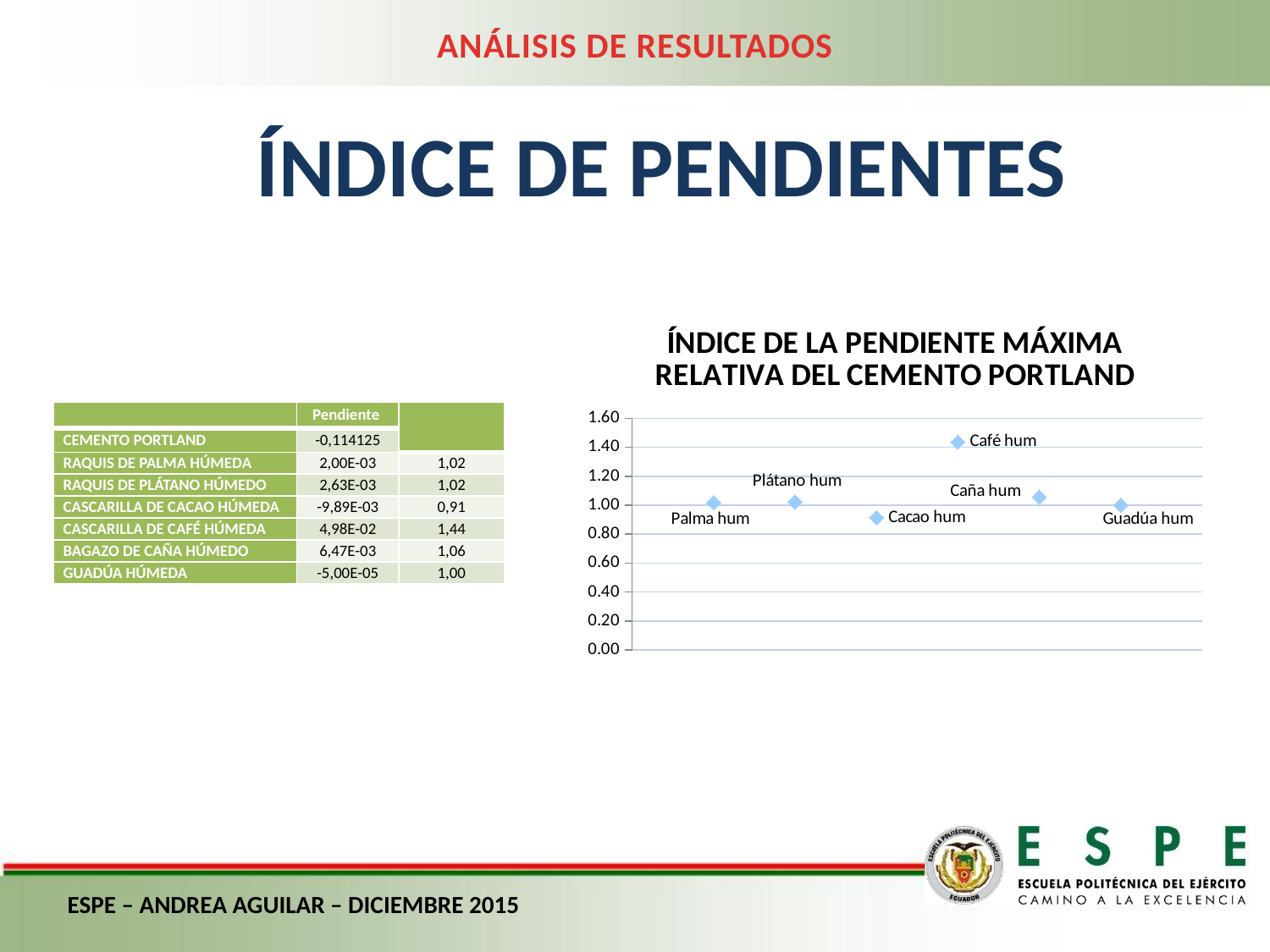
What is the title of the chart on the slide? ÍNDICE DE LA PENDIENTE MÁXIMA RELATIVA DEL CEMENTO PORTLAND Which has the larger value, Palma hum or Cacao hum? Palma hum What is the highest value shown on the vertical axis of the chart? 1.60 What kind of chart is shown on the slide? scatter chart Which has the larger value, Café hum or Caña hum? Café hum How many data points are plotted in the chart? 6 Which labelled point has the lowest value in the chart? Cacao hum Is the value for Cacao hum greater or less than 1.00? less Which labelled point has the highest value in the chart? Café hum Is the value for Plátano hum greater or less than 1.20? less Is the value for Café hum greater or less than 1.20? greater